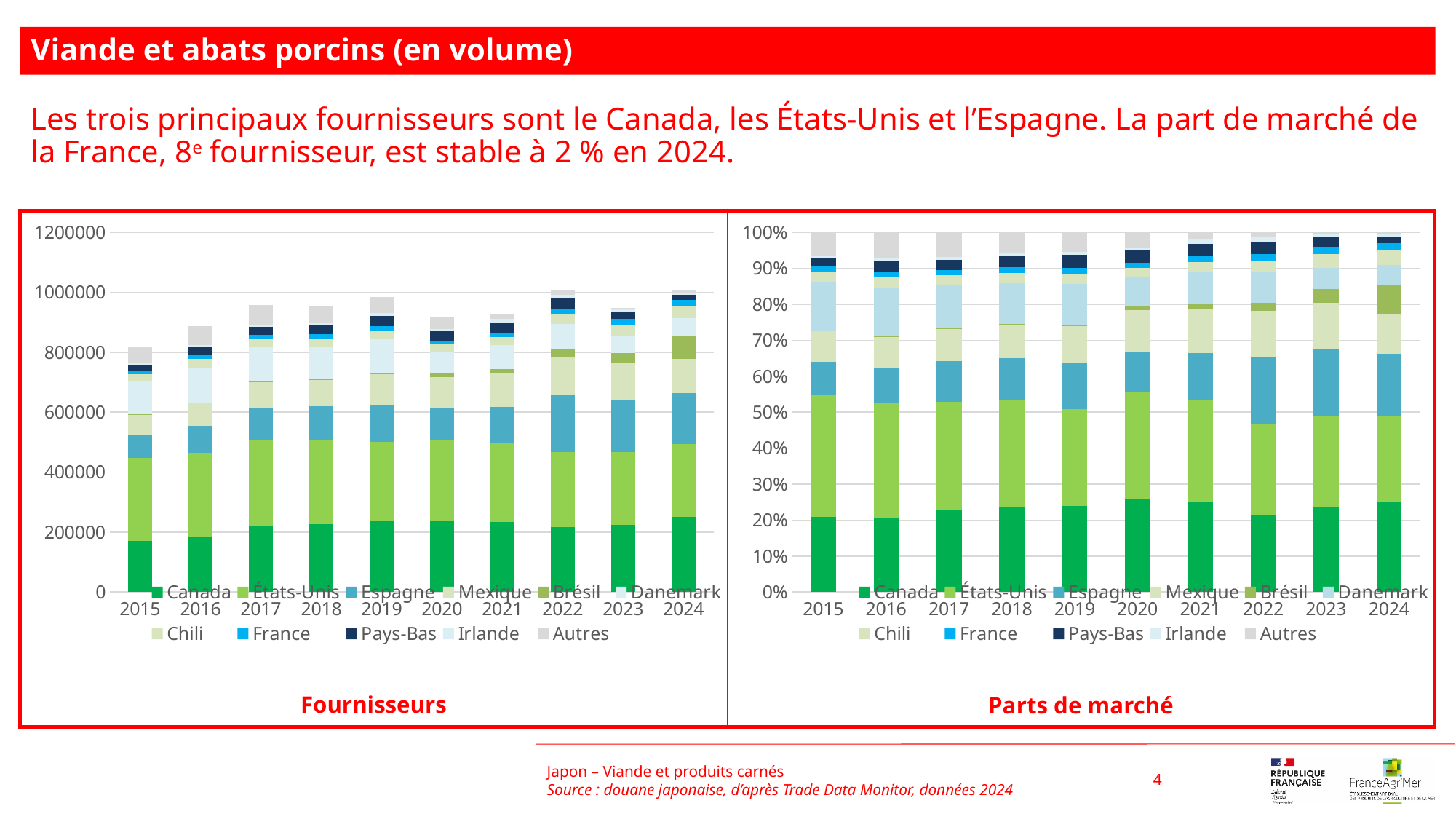
In the 'Parts de marché' chart, does the 'Autres' share rise or fall from 2015 to 2024? fall In the 'Parts de marché' chart, which is larger in 2024, the Canada share or the Espagne share? Canada How many years are shown on the x axis of the 'Parts de marché' chart? 10 In the 'Parts de marché' chart, is the Canada share for 2020 greater or less than 20%? greater How many series does the legend of the 'Fournisseurs' chart list? 11 What is the title of the chart on the right of the slide? Parts de marché In the 'Fournisseurs' chart, is the Canada segment for 2024 greater or less than 200000? greater In the 'Fournisseurs' chart, which is larger, the total bar for 2015 or the total bar for 2024? 2024 In the 'Fournisseurs' chart, which year has the lowest total bar? 2015 In the 'Fournisseurs' chart, is the total bar for 2015 greater or less than 1000000? less What kind of chart is the 'Fournisseurs' chart on the left? stacked bar chart